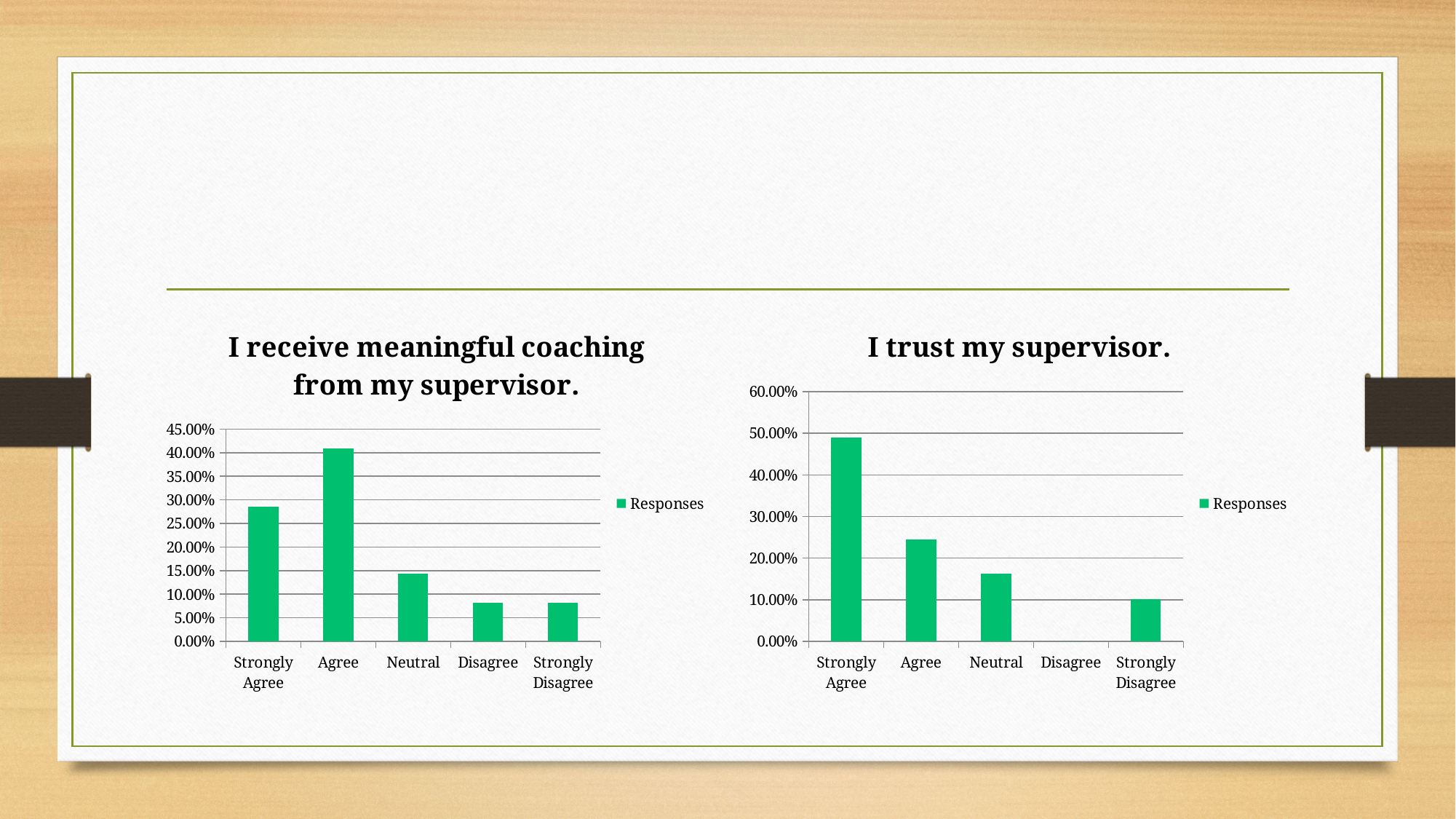
In the chart "I trust my supervisor.", which is larger, Agree or Neutral? Agree In the chart "I receive meaningful coaching from my supervisor.", which is larger, Neutral or Disagree? Neutral In the chart "I receive meaningful coaching from my supervisor.", which category has the highest value? Agree In the chart "I trust my supervisor.", is the value for Strongly Agree greater or less than 40.00%? greater In the chart "I receive meaningful coaching from my supervisor.", is the value for Strongly Agree greater or less than 30.00%? less In the chart "I receive meaningful coaching from my supervisor.", is the value for Agree greater or less than 40.00%? greater What kind of chart is "I receive meaningful coaching from my supervisor."? bar chart How many series does the legend of the chart "I trust my supervisor." list? 1 How many categories are shown on the x axis of the chart "I receive meaningful coaching from my supervisor."? 5 In the chart "I trust my supervisor.", which category has the highest value? Strongly Agree In the chart "I trust my supervisor.", which category has the lowest value? Disagree